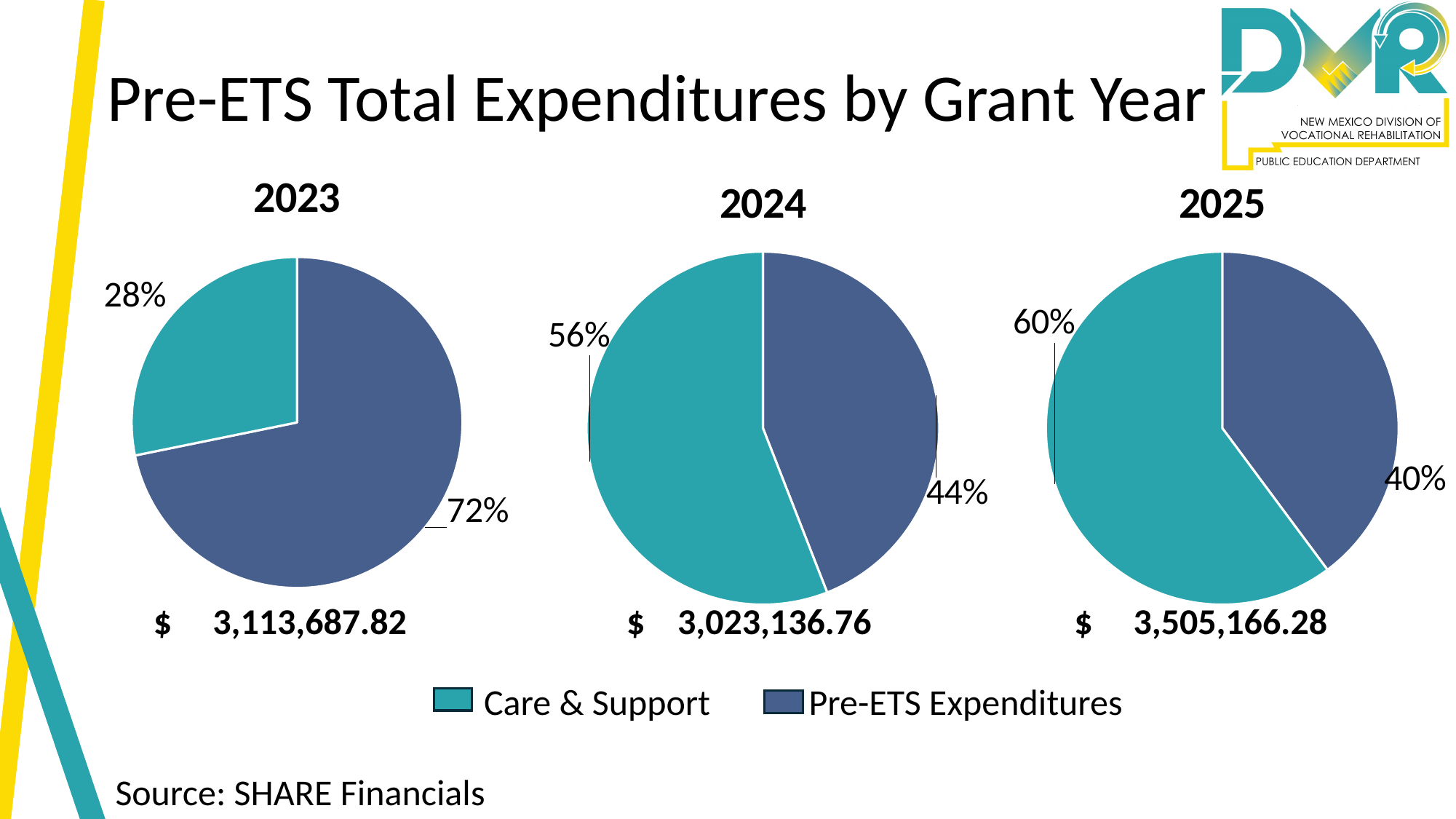
In the 2023 pie chart, what share of expenditures is Pre-ETS Expenditures? 72% In the 2024 pie chart, what share of expenditures is Care & Support? 56% How many series does the legend list? 2 What total expenditure amount is shown below the 2025 pie chart? $ 3,505,166.28 In the 2024 pie chart, what is the difference in percentage points between the Care & Support share and the Pre-ETS Expenditures share? 12 In the 2024 pie chart, what share of expenditures is Pre-ETS Expenditures? 44% What kind of chart is used for each grant year on this slide? Pie chart In the 2025 pie chart, which category has the larger share? Care & Support In the 2023 pie chart, which category has the smaller share? Care & Support What total expenditure amount is shown below the 2024 pie chart? $ 3,023,136.76